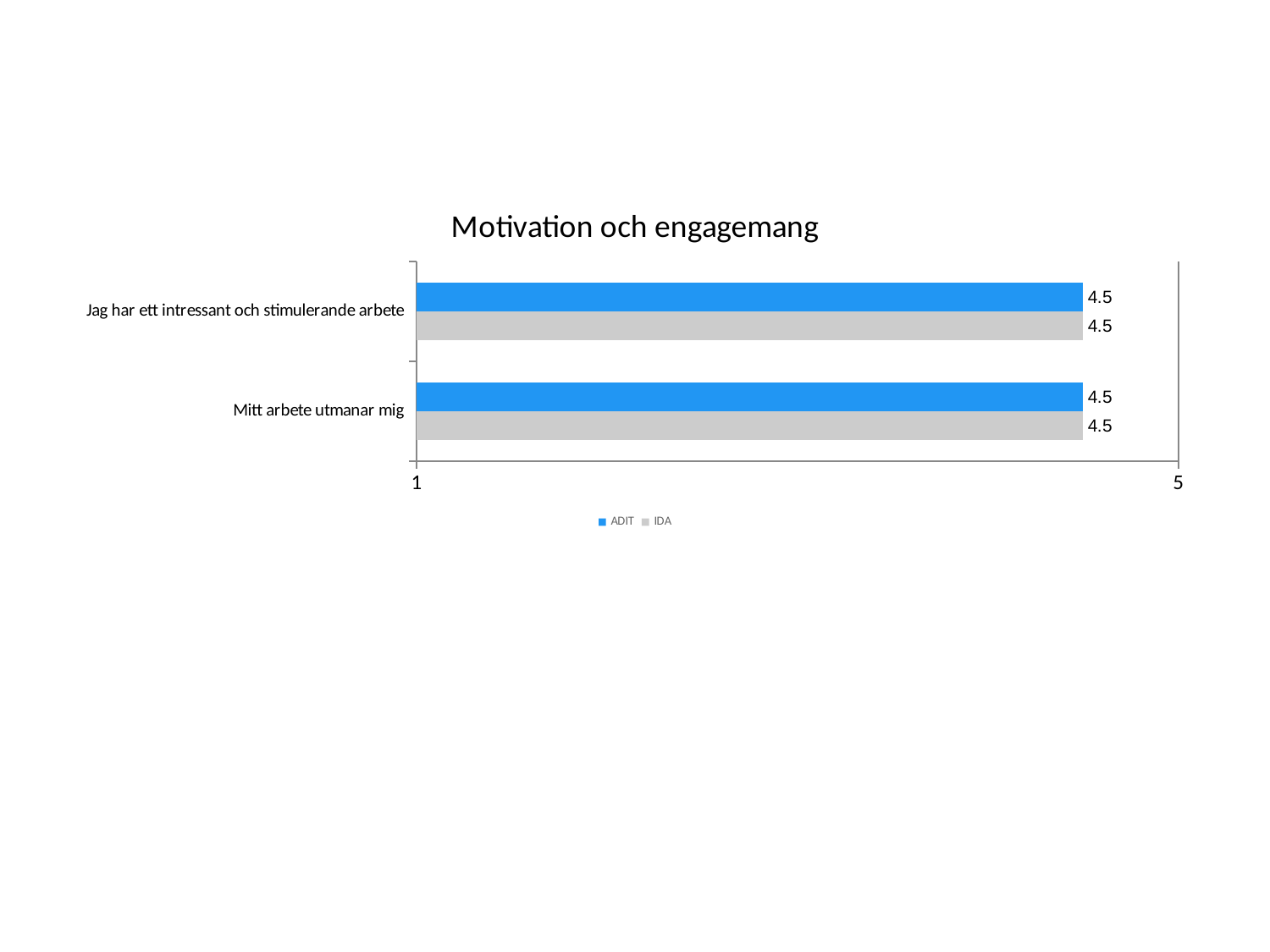
Which series is shown in blue? ADIT What is the difference between the ADIT values for the two categories? 0 How many categories are shown on the chart? 2 Is the IDA value for "Mitt arbete utmanar mig" greater or less than 1? greater What kind of chart is shown on the slide? Bar chart How many series does the legend list? 2 What is the IDA value for "Jag har ett intressant och stimulerande arbete"? 4.5 What is the difference between the ADIT and IDA values for "Mitt arbete utmanar mig"? 0 What is the ADIT value for "Jag har ett intressant och stimulerande arbete"? 4.5 What is the ADIT value for "Mitt arbete utmanar mig"? 4.5 What is the title of the chart? Motivation och engagemang What is the IDA value for "Mitt arbete utmanar mig"? 4.5